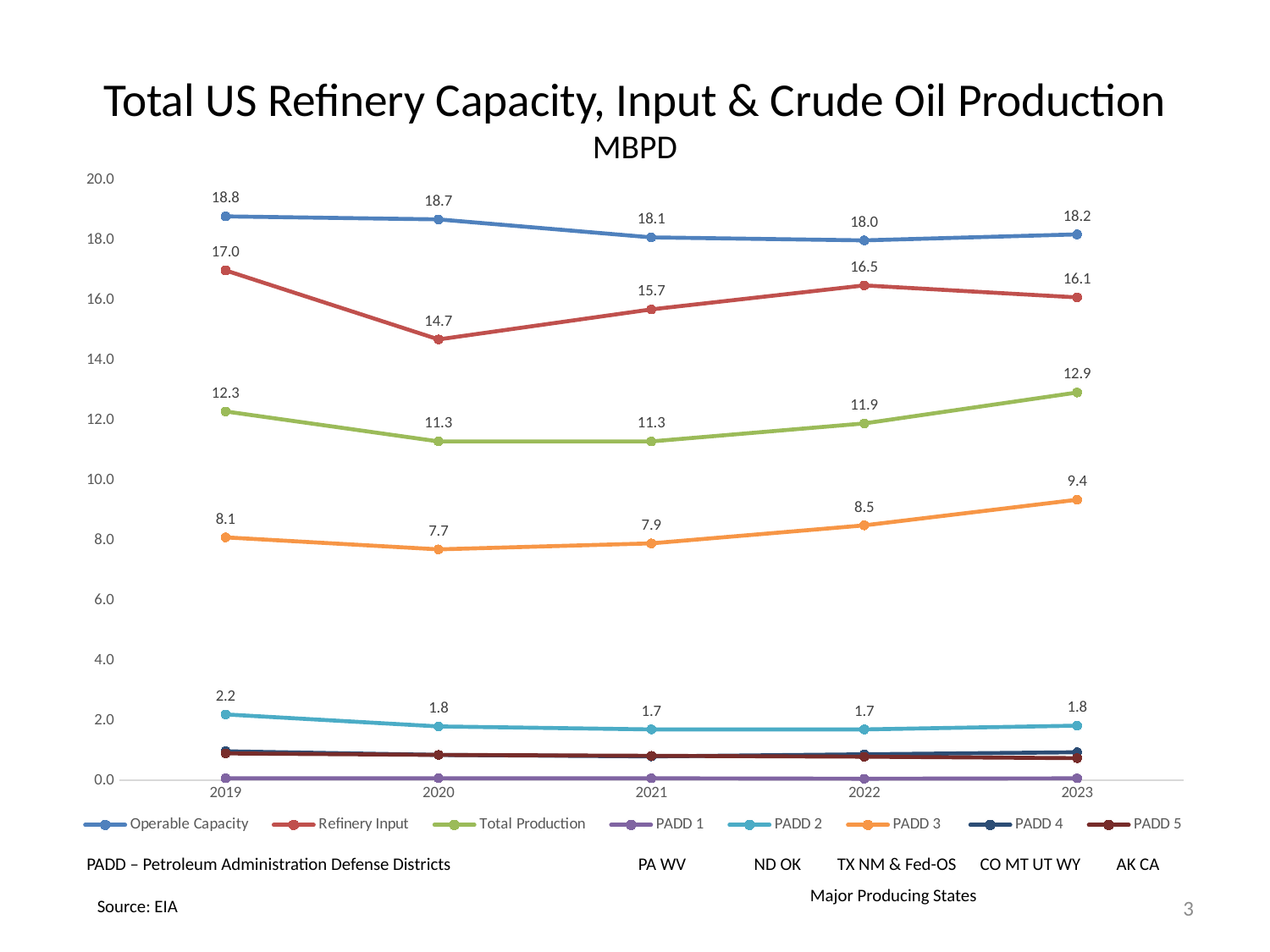
What is the difference between Operable Capacity and Refinery Input in 2019? 1.8 What is the Operable Capacity value for 2019? 18.8 What is the Total Production value for 2023? 12.9 What kind of chart is shown on the slide? Line chart In which year is PADD 3 highest? 2023 What is the Refinery Input value for 2020? 14.7 How many series does the legend list? 8 In which year is Refinery Input lowest? 2020 Is the PADD 4 value for 2021 greater or less than 2.0? less What is the PADD 3 value for 2022? 8.5 Which is larger in 2023, Total Production or PADD 3? Total Production Does Refinery Input rise or fall from 2020 to 2022? Rise